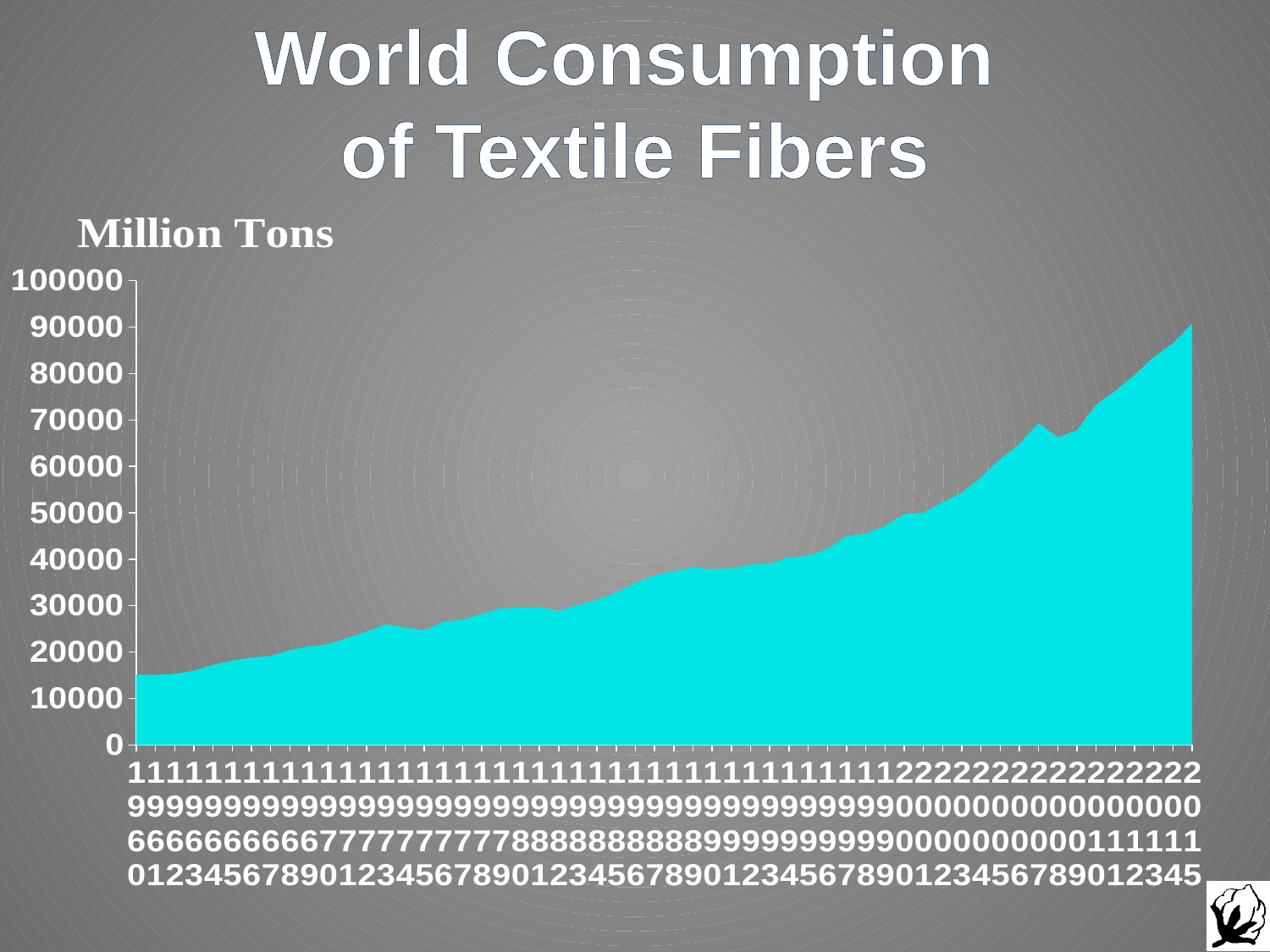
Which year has the larger value, 1960 or 2015? 2015 What is the title of the chart? World Consumption of Textile Fibers Is the value for 2015 greater or less than 80000? greater Do the values generally rise or fall from 1960 to 2015? rise Is the value for 2010 greater or less than 70000? greater Is the value for 2005 greater or less than 50000? greater What unit label is shown above the vertical axis? Million Tons Which year has the highest consumption value? 2015 What kind of chart is shown on the slide? area chart